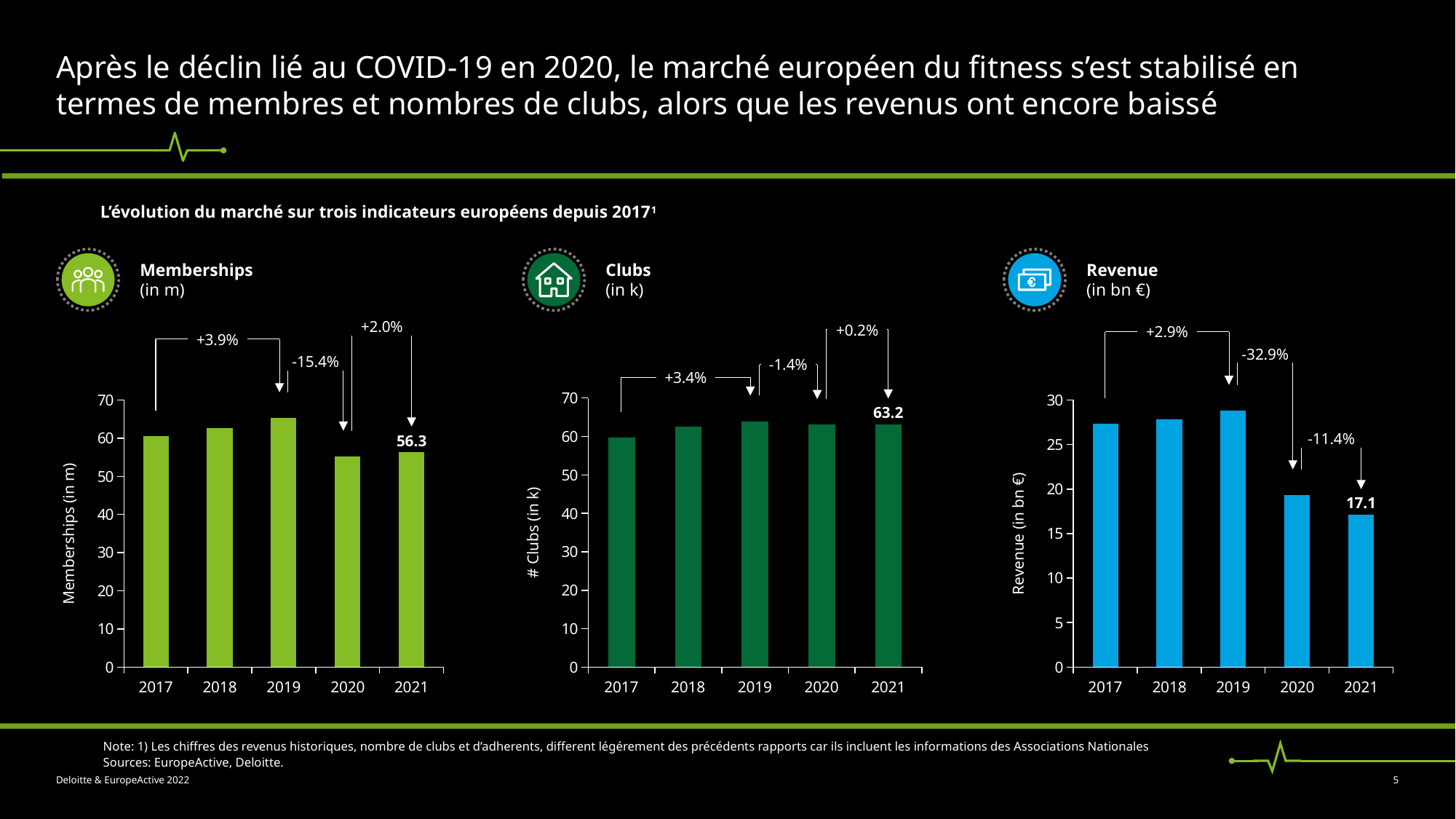
On the Clubs chart, which year has the lowest value? 2017 On the Memberships chart, what is the value for 2021? 56.3 On the Memberships chart, which year has the highest value? 2019 How many years are shown on the Clubs chart? 5 On the Revenue chart, what is the value for 2021? 17.1 On the Memberships chart, which year has the lowest value? 2020 On the Revenue chart, which year has the lowest value? 2021 On the Revenue chart, is the value for 2020 greater or less than 20? less On the Memberships chart, is the value for 2019 greater or less than 60? greater On the Revenue chart, which is larger, the value for 2017 or the value for 2020? 2017 On the Clubs chart, what is the value for 2021? 63.2 On the Revenue chart, what percentage change is shown between 2019 and 2020? -32.9%